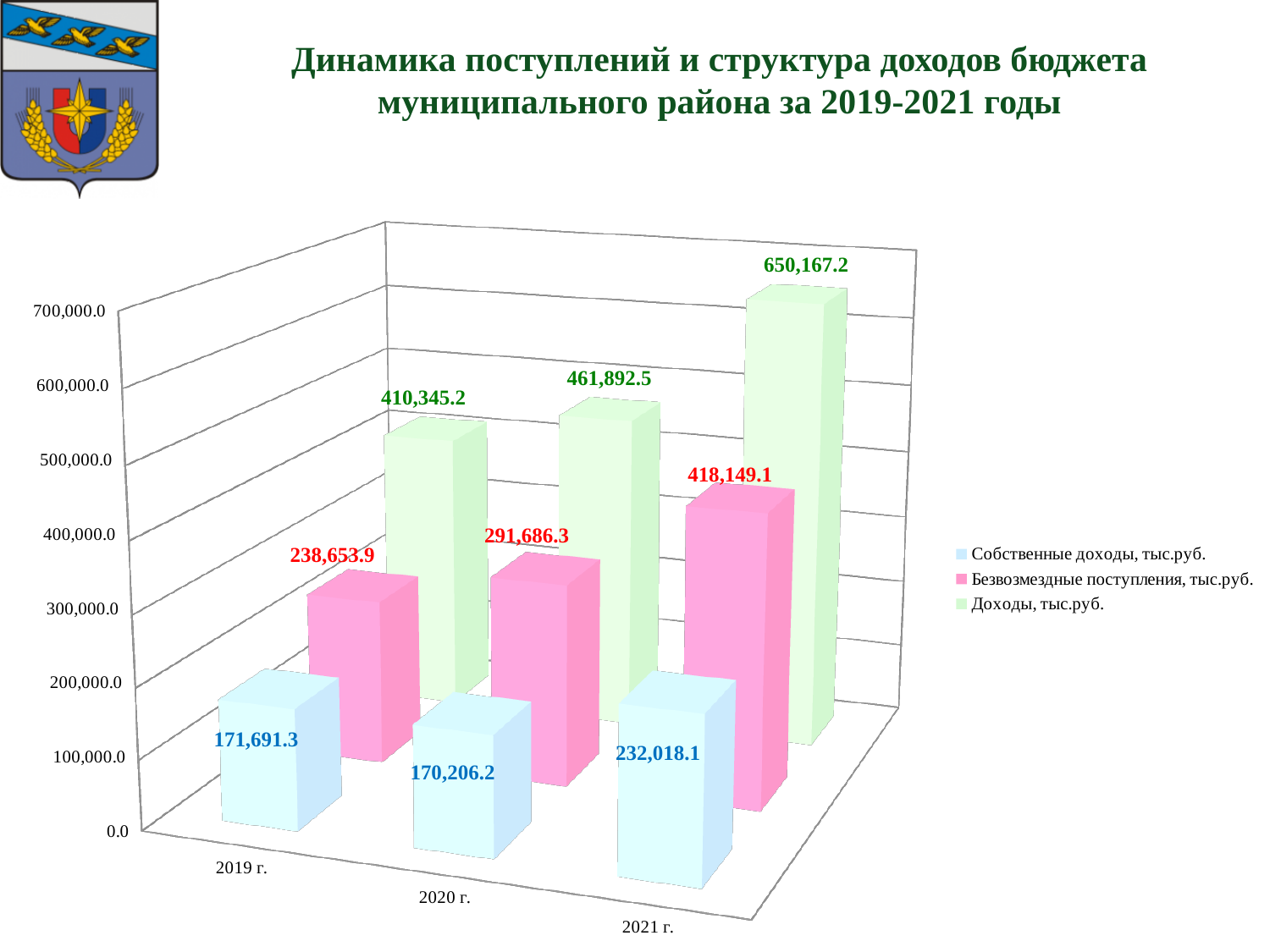
Which is larger: Безвозмездные поступления, тыс.руб. in 2019 г. or Собственные доходы, тыс.руб. in 2021 г.? Безвозмездные поступления, тыс.руб. in 2019 г. What is the value of Доходы, тыс.руб. for 2021 г.? 650,167.2 In which year is Доходы, тыс.руб. highest? 2021 г. Do the values of Безвозмездные поступления, тыс.руб. rise or fall from 2019 г. to 2021 г.? Rise What is the value of Собственные доходы, тыс.руб. for 2019 г.? 171,691.3 In which year is Собственные доходы, тыс.руб. lowest? 2020 г. What is the difference between Безвозмездные поступления, тыс.руб. in 2021 г. and in 2019 г.? 179,495.2 How many series does the legend list? 3 How many years are shown on the x axis? 3 What kind of chart is shown on the slide? Bar chart What is the difference between Доходы, тыс.руб. in 2021 г. and in 2020 г.? 188,274.7 What is the value of Безвозмездные поступления, тыс.руб. for 2020 г.? 291,686.3